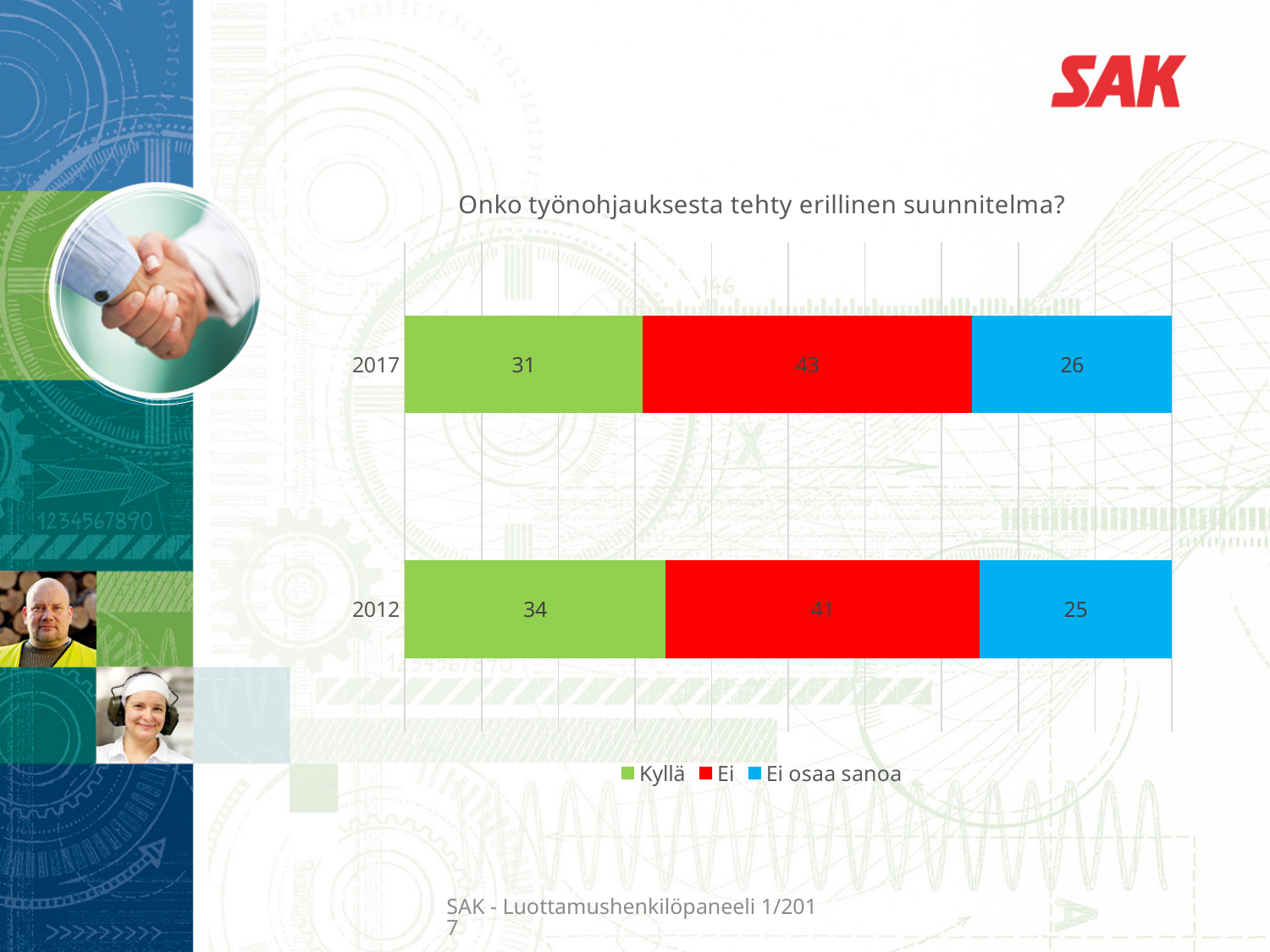
What is the difference between the "Ei" value in 2017 and the "Ei" value in 2012? 2 What kind of chart is shown on the slide? Stacked bar chart What is the value for "Ei" in 2012? 41 How many categories (years) are shown on the chart? 2 What is the value for "Kyllä" in 2017? 31 Which series has the highest value in 2017? Ei Which is larger: the "Kyllä" value in 2012 or the "Kyllä" value in 2017? 2012 How many series does the legend list? 3 What is the value for "Ei osaa sanoa" in 2017? 26 What is the value for "Kyllä" in 2012? 34 What is the total of the stacked bar for 2017? 100 Which series has the lowest value in 2012? Ei osaa sanoa